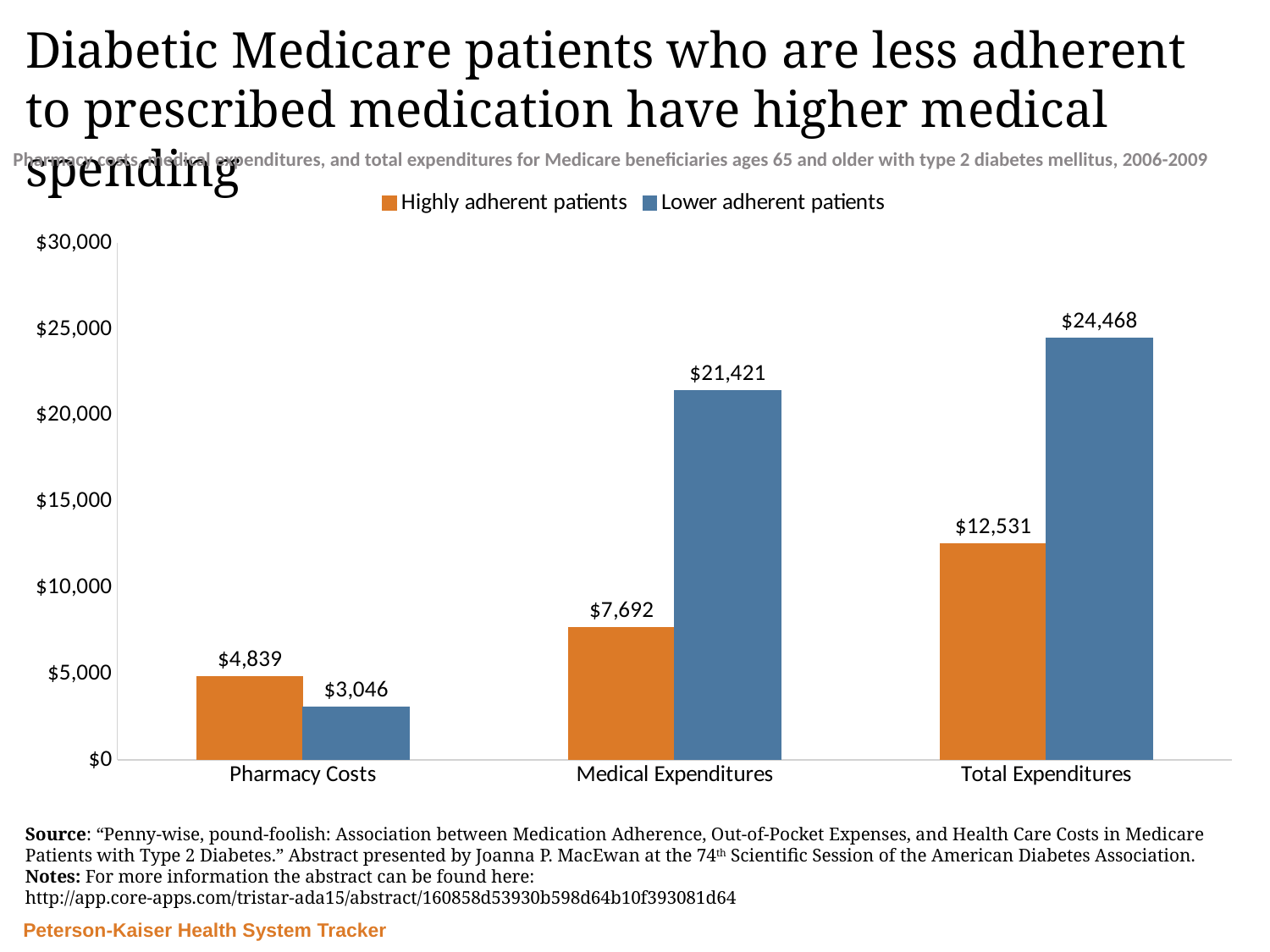
What is the difference in pharmacy costs between highly adherent and lower adherent patients? $1,793 Which category has the lowest value for highly adherent patients? Pharmacy Costs What are the pharmacy costs for highly adherent patients? $4,839 Which category has the highest value for lower adherent patients? Total Expenditures What is the difference in total expenditures between lower adherent and highly adherent patients? $11,937 Is the value for medical expenditures for lower adherent patients greater or less than $20,000? greater For pharmacy costs, which group has the larger value: highly adherent or lower adherent patients? Highly adherent patients How many series does the legend list? 2 What kind of chart is shown on the slide? Bar chart What are the medical expenditures for lower adherent patients? $21,421 What are the total expenditures for highly adherent patients? $12,531 How many categories are shown on the x axis? 3